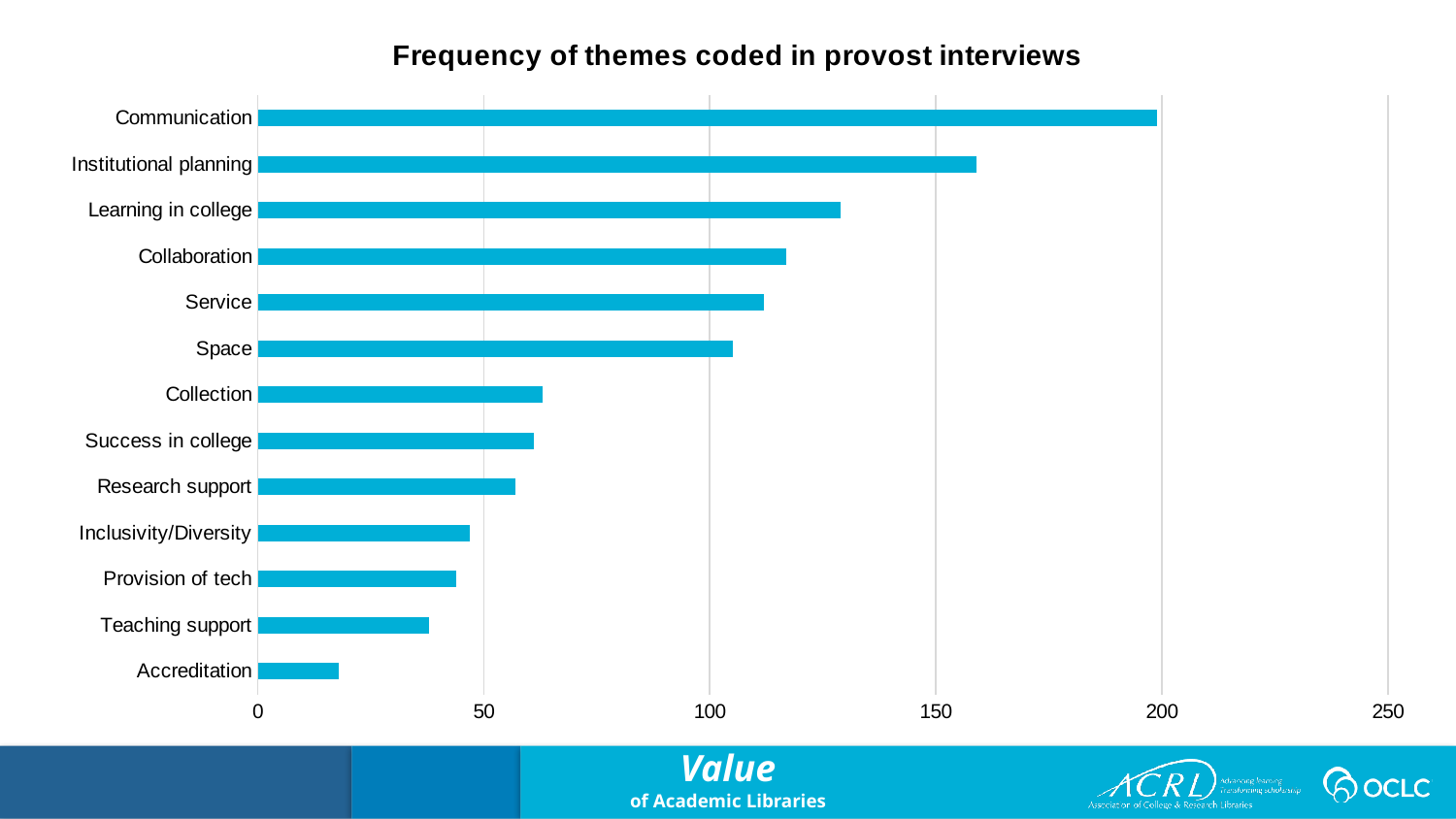
Which theme has the highest frequency? Communication Is the value for Learning in college greater or less than 150? less Is the value for Communication greater or less than 150? greater What is the title of the chart? Frequency of themes coded in provost interviews Is the value for Institutional planning greater or less than 150? greater How many themes (categories) are plotted in the chart? 13 What type of chart is shown on the slide? bar chart Which theme has the lowest frequency? Accreditation Which has a higher frequency, Communication or Institutional planning? Communication Which has a higher frequency, Space or Collection? Space